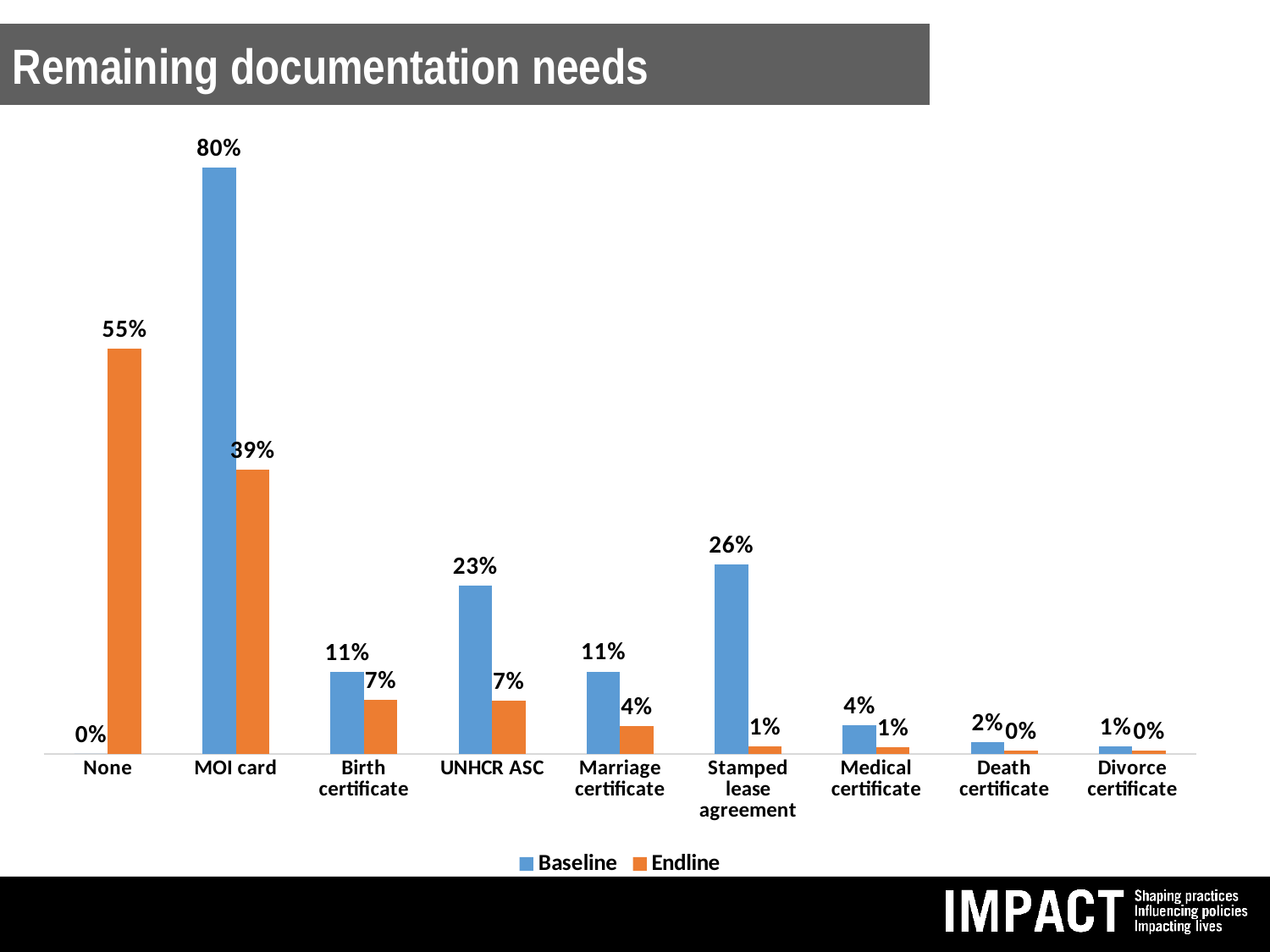
What is the difference between the Baseline and Endline values for MOI card? 41% What is the Endline value for None? 55% How many series does the legend list? 2 How many categories are shown on the x axis? 9 What colour are the Endline bars? Orange Which category has the lowest Baseline value? None What kind of chart is shown on the slide? Bar chart What is the Endline value for Stamped lease agreement? 1% What is the Baseline value for MOI card? 80% What is the Baseline value for UNHCR ASC? 23% Which category has the highest Baseline value? MOI card Which is larger, the Baseline value for Stamped lease agreement or the Baseline value for UNHCR ASC? Stamped lease agreement